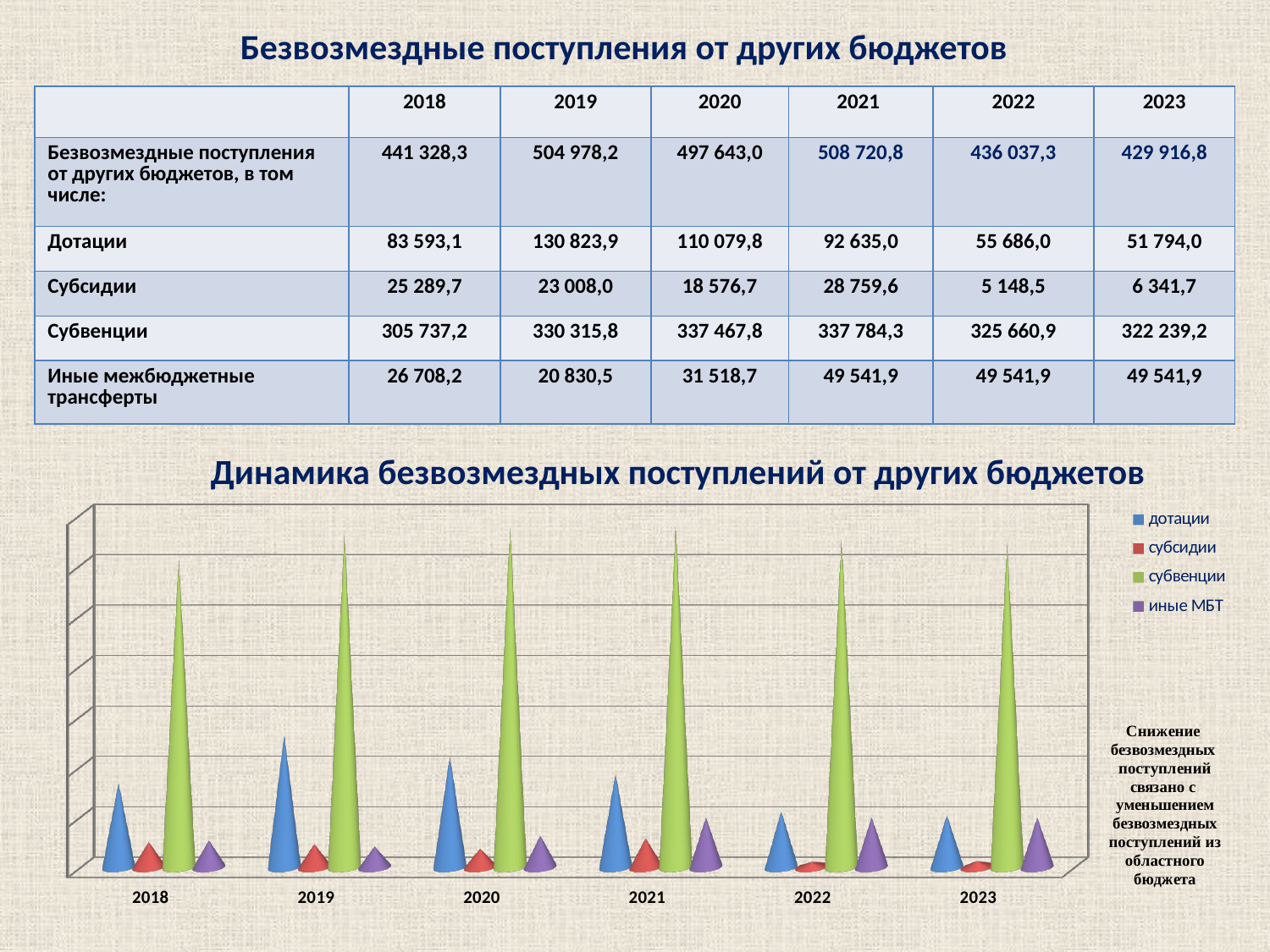
How many years are shown along the x axis of the chart? 6 On the chart, is the 'субсидии' value larger in 2018 or in 2022? 2018 On the chart, is the 'дотации' value in 2018 larger or smaller than the 'иные МБТ' value in 2018? larger What kind of chart is shown under the title 'Динамика безвозмездных поступлений от других бюджетов'? bar chart Which series has the highest value in every year of the chart? субвенции Does the 'дотации' series rise or fall from 2019 to 2023 on the chart? fall In which year is the 'дотации' series highest on the chart? 2019 According to the table on the slide, what is the value of 'Субвенции' for 2021? 337 784,3 Which colour represents 'субвенции' in the chart legend? green What is the last legend entry of the chart? иные МБТ How many series does the legend of the chart list? 4 Which series has the lowest value in 2022 on the chart? субсидии